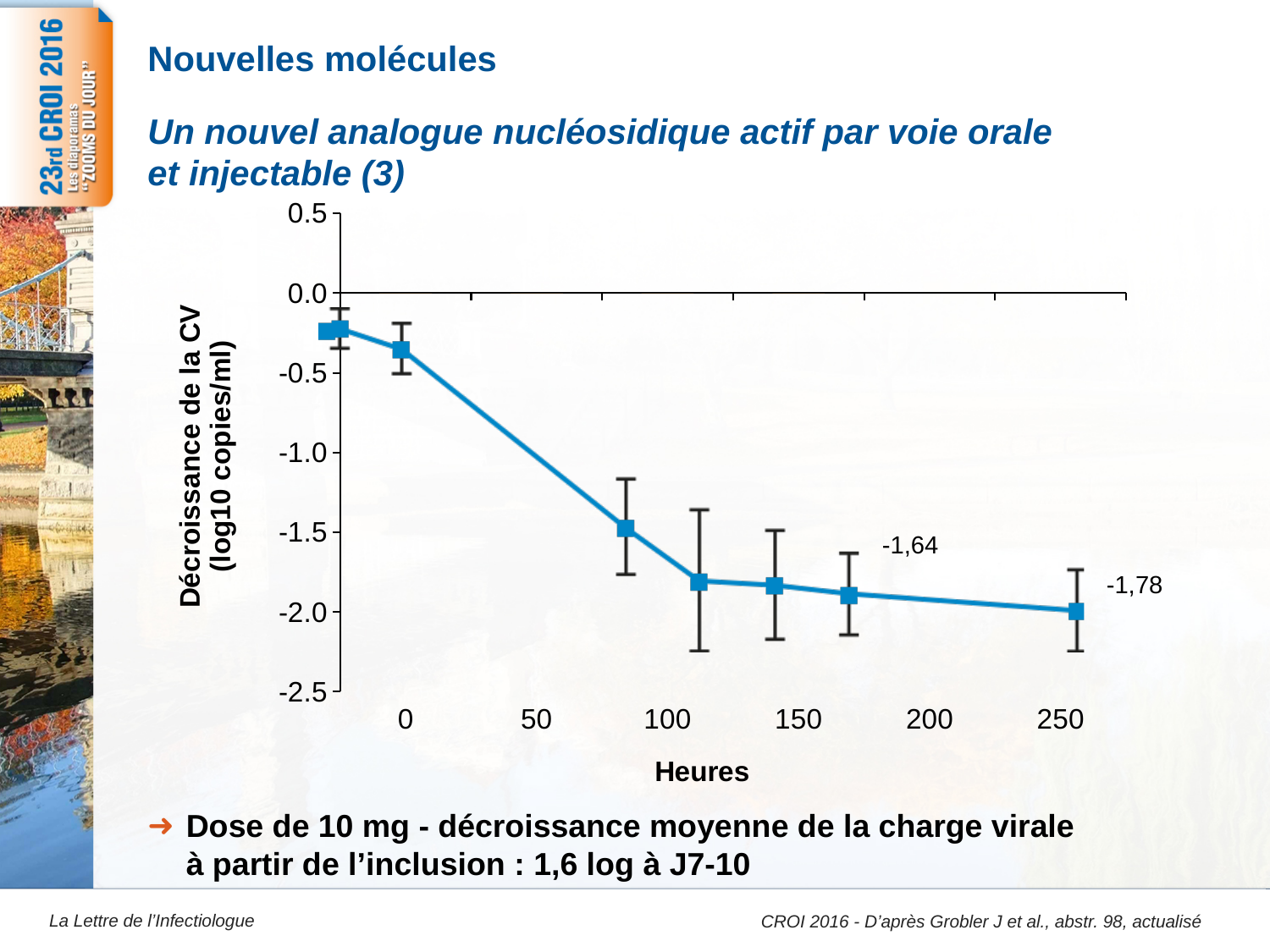
Which of the two printed data labels is lower, -1,64 or -1,78? -1,78 Do the values rise or fall as the hours increase along the x axis? fall Is the value at 0 hours greater or less than -0.5? greater What kind of chart is shown on the slide? line chart Is the value at about 85 hours greater or less than -1.0? less What is the data label printed next to the last point of the line (around 250 hours)? -1,78 What is the title of the x axis? Heures Which point on the line is the lowest? the last point, near 250 hours How many data points are plotted on the line? 7 What is the difference between the two printed data labels, -1,64 and -1,78? 0,14 What is the data label printed near the point at about 170 hours? -1,64 What is the title of the y axis? Décroissance de la CV (log10 copies/ml)